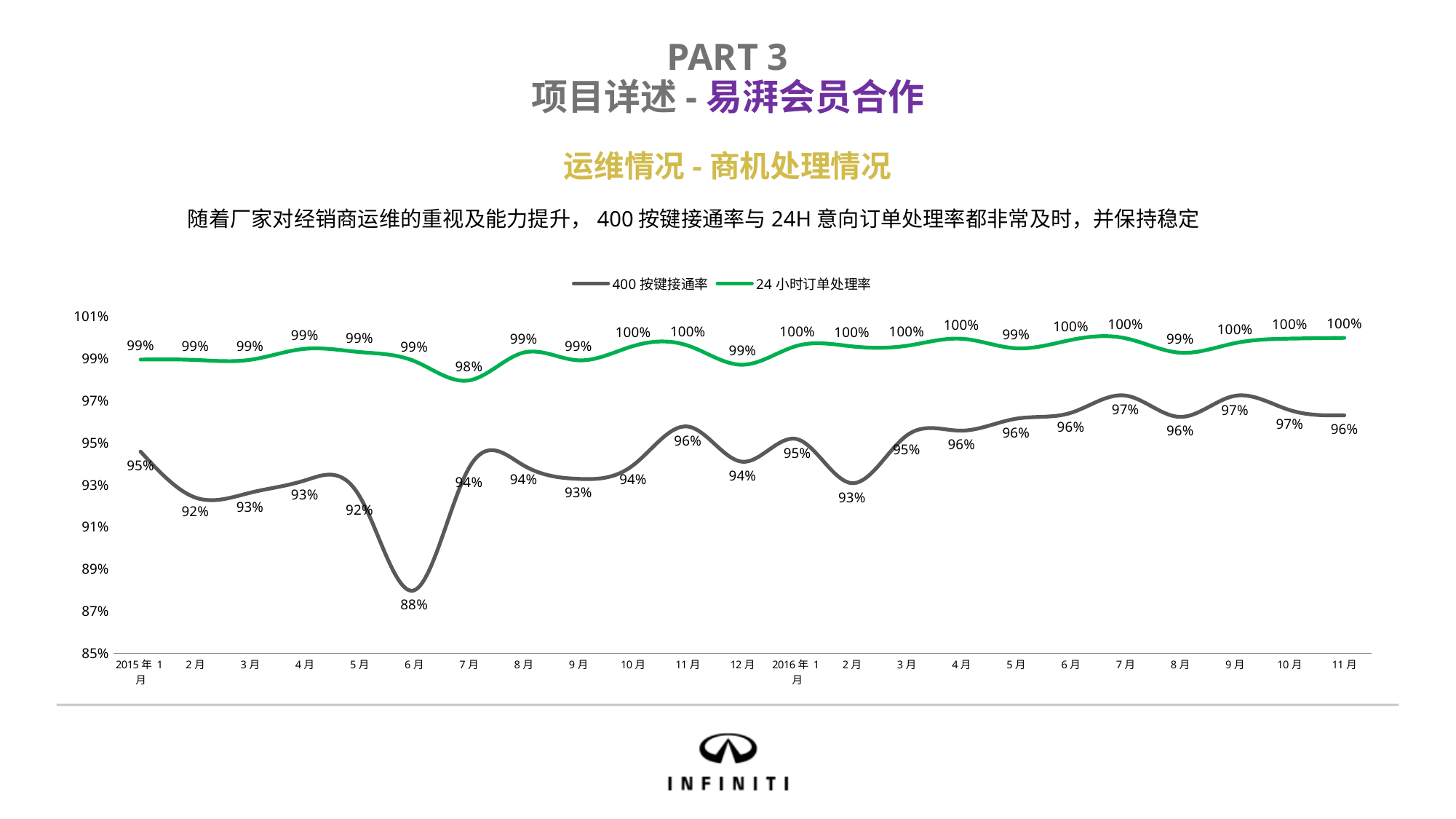
What is the difference between 24 小时订单处理率 and 400 按键接通率 in 2015年6月? 11% What type of chart is shown on the slide? line chart How many months are plotted on the x axis? 23 What is the value of 400 按键接通率 in 2016年7月? 97% In which month is 24 小时订单处理率 at its lowest? 2015年7月 What is the value of 24 小时订单处理率 in 2015年7月? 98% What is the value of 400 按键接通率 in 2015年6月? 88% Which is larger for 400 按键接通率: 2015年1月 or 2015年2月? 2015年1月 In which month is 400 按键接通率 at its lowest? 2015年6月 Does 400 按键接通率 generally rise or fall from 2015年6月 to 2016年11月? rise What colour is the line for 24 小时订单处理率? green How many series does the legend list? 2